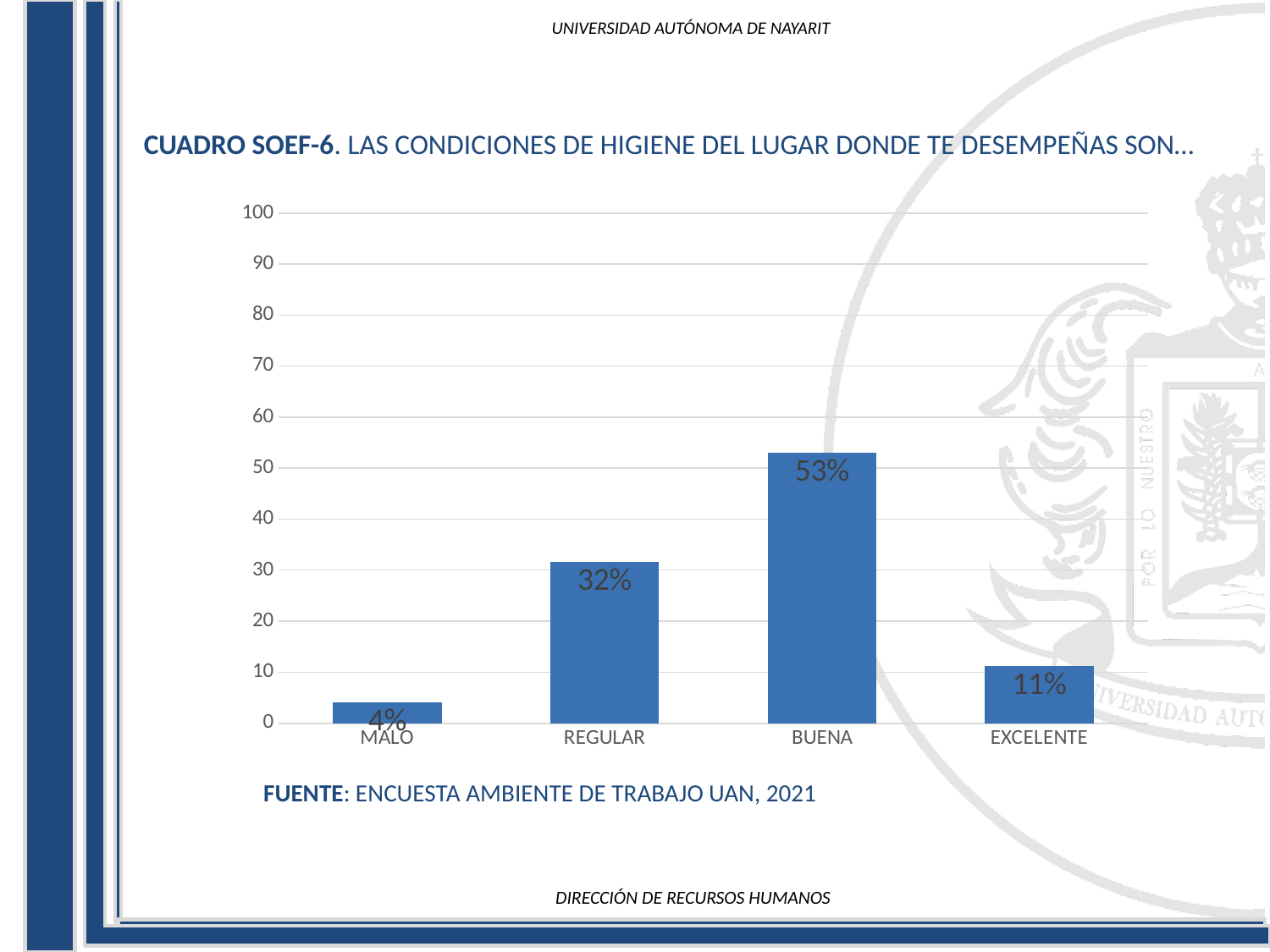
Which is larger, the value for REGULAR or the value for EXCELENTE? REGULAR What is the value for EXCELENTE? 11% Which category has the highest value? BUENA What is the difference between the values for BUENA and REGULAR? 21% What is the value for BUENA? 53% What is the value for REGULAR? 32% Which category has the lowest value? MALO Is the value for BUENA greater or less than 50? greater How many categories are shown on the x axis? 4 What source is cited below the chart? ENCUESTA AMBIENTE DE TRABAJO UAN, 2021 What is the value for MALO? 4% What kind of chart is shown on the slide? Bar chart